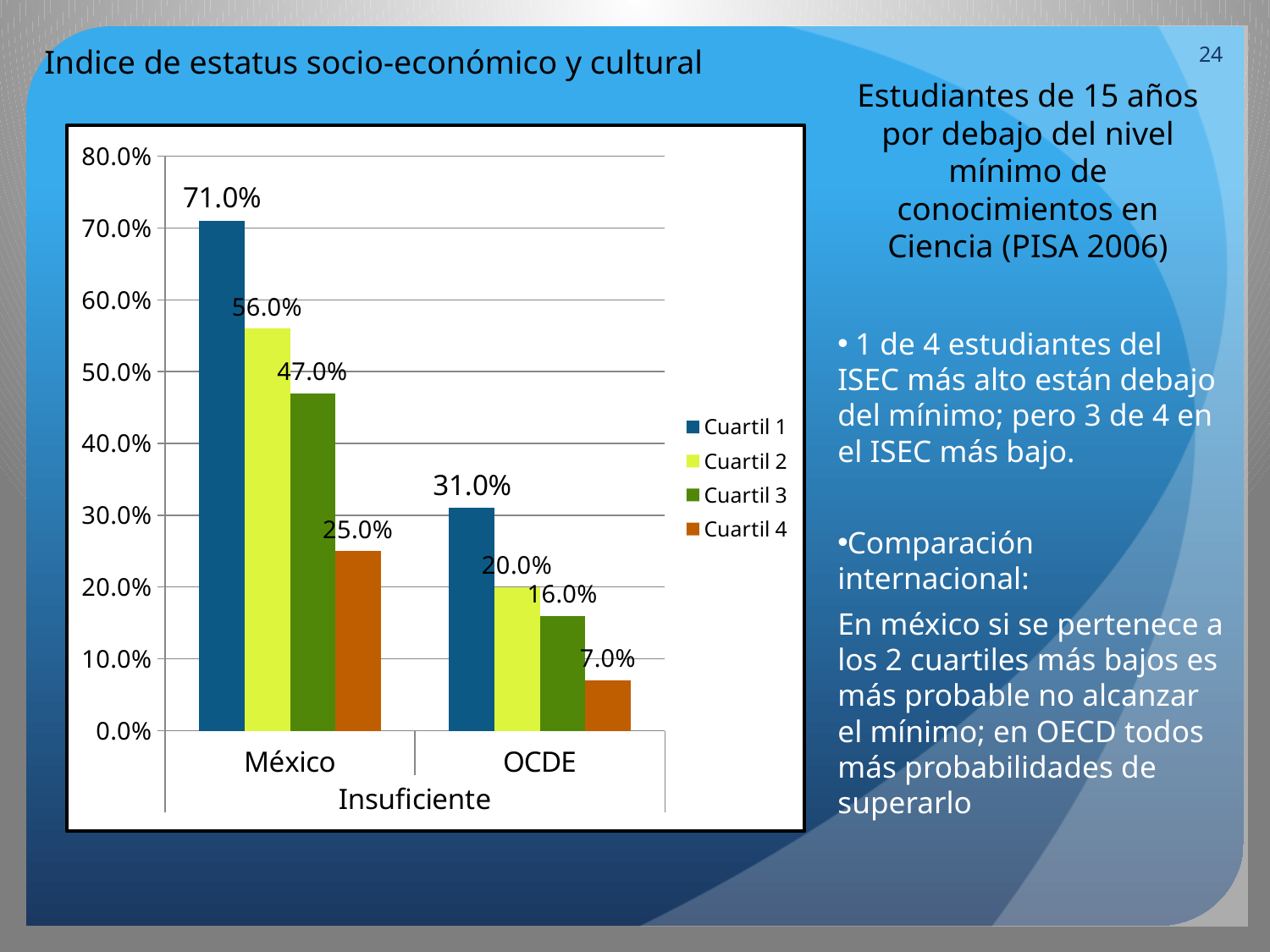
What is the value for Cuartil 3 in México? 47.0% Which series has the highest value for México? Cuartil 1 What kind of chart is shown on the slide? Bar chart What is the difference between Cuartil 1 in México and Cuartil 1 in OCDE? 40.0% Which series has the lowest value for OCDE? Cuartil 4 What is the value for Cuartil 1 in México? 71.0% What is the label shown below the category names on the x axis? Insuficiente How many categories are shown on the x axis? 2 How many series does the legend list? 4 What is the value for Cuartil 4 in OCDE? 7.0% What is the value for Cuartil 2 in OCDE? 20.0% Which is larger: Cuartil 4 in México or Cuartil 2 in OCDE? Cuartil 4 in México